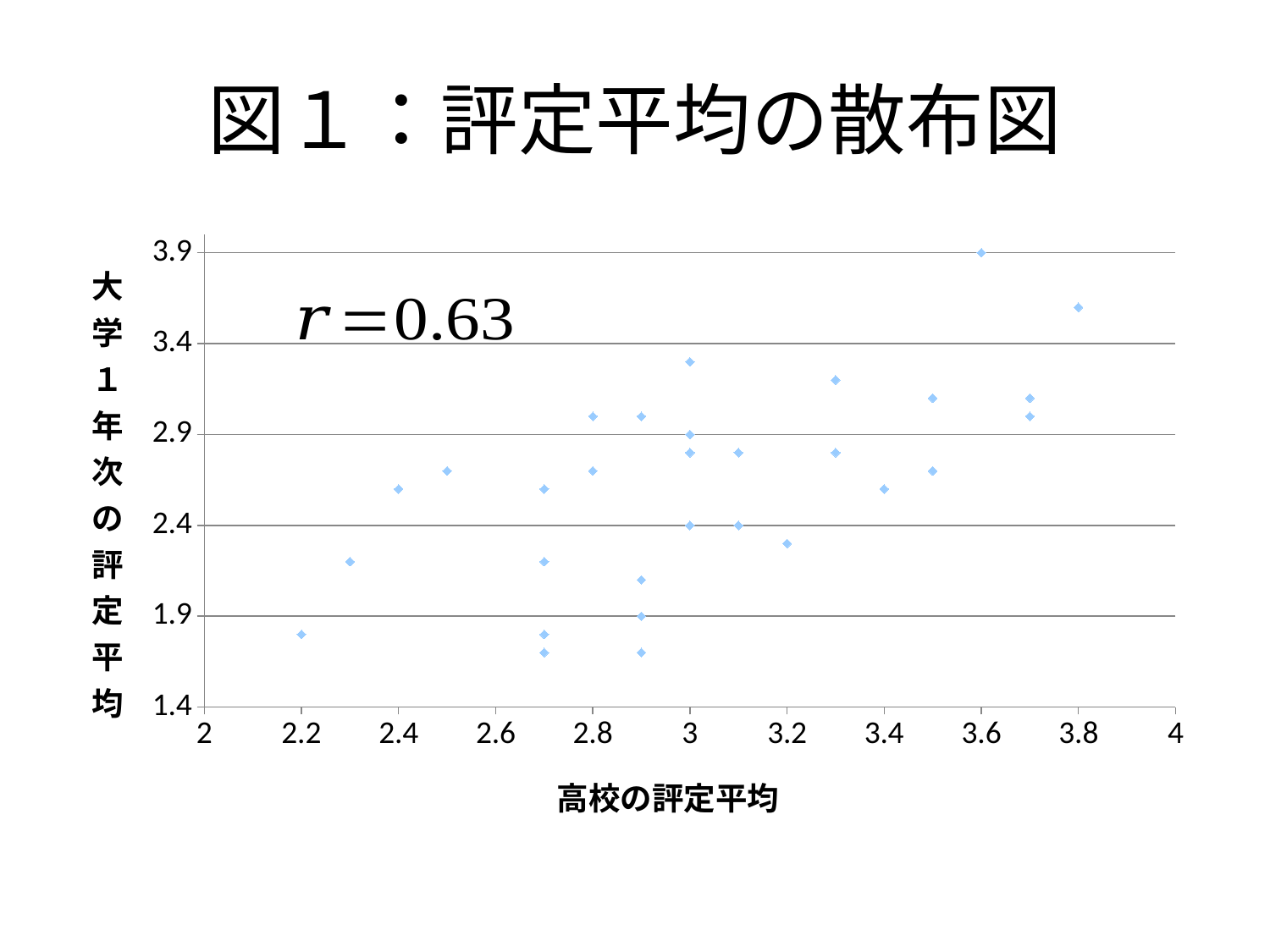
What is the lowest 高校の評定平均 value among the plotted points? 2.2 Is the 大学１年次の評定平均 value for the point at 高校の評定平均 2.2 greater or less than 1.9? less How many points are plotted at 高校の評定平均 3.0? 4 Do the 大学１年次の評定平均 values generally rise or fall as 高校の評定平均 increases? rise What is the title of the chart? 図１：評定平均の散布図 What is the 大学１年次の評定平均 value of the highest point on the chart? 3.9 What kind of chart is shown on the slide? scatter plot Which has the higher 大学１年次の評定平均: the point at 高校の評定平均 3.6 or the point at 高校の評定平均 2.2? the point at 3.6 Is the 大学１年次の評定平均 value for the point at 高校の評定平均 3.8 greater or less than 3.4? greater What is the 高校の評定平均 value of the point with the highest 大学１年次の評定平均? 3.6 What correlation coefficient r is printed on the chart? r = 0.63 Is the 大学１年次の評定平均 value for the point at 高校の評定平均 2.5 greater or less than 2.4? greater